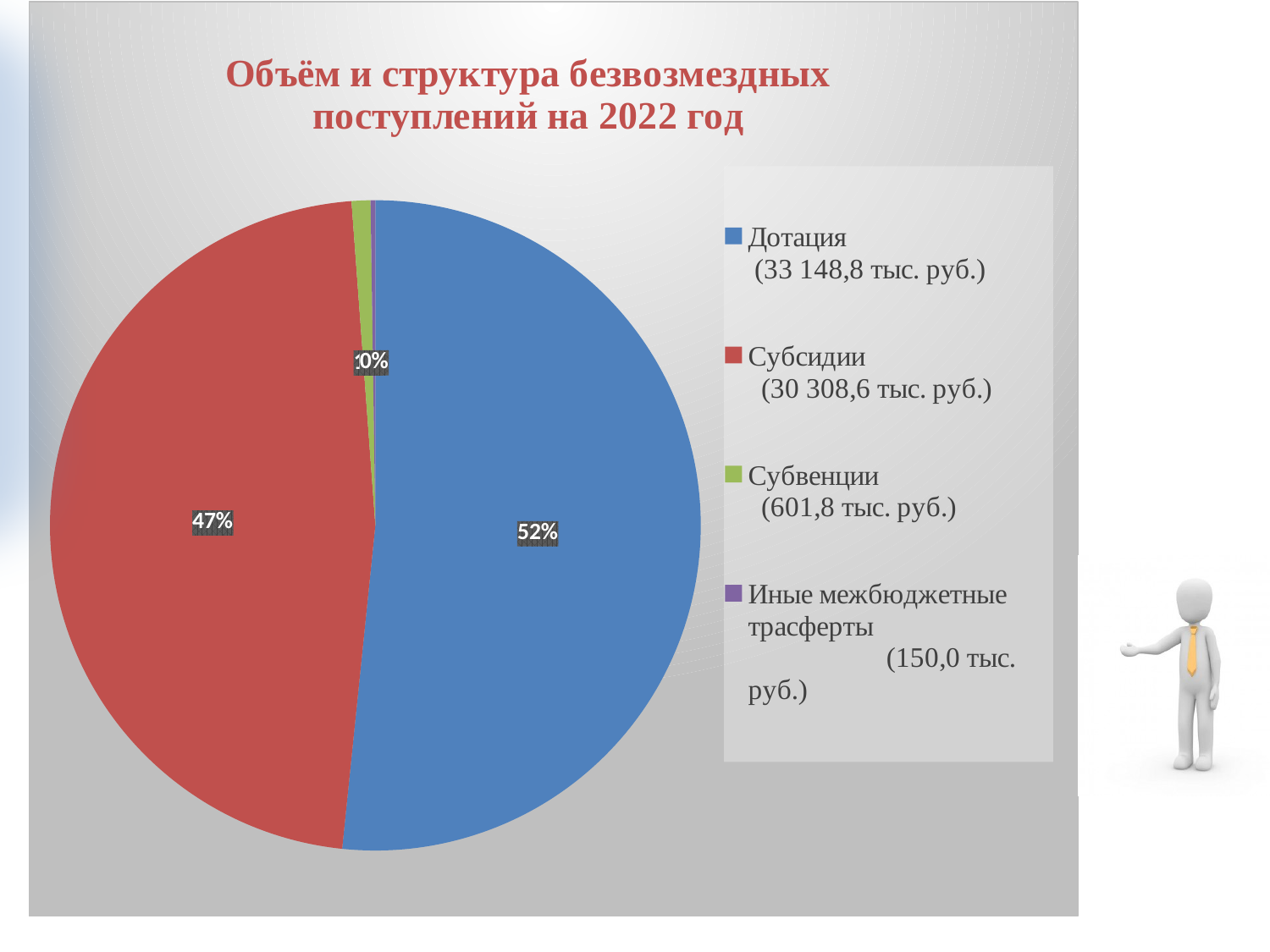
What kind of chart is shown on the slide? pie chart What amount is shown in the legend for Иные межбюджетные трасферты? 150,0 тыс. руб. What share of the pie does Дотация account for? 52% By how many percentage points does the share for Дотация exceed the share for Субсидии? 5 Which category has the largest slice of the pie? Дотация What amount is shown in the legend for Дотация? 33 148,8 тыс. руб. How many categories does the pie chart show? 4 Which category has the smallest slice of the pie? Иные межбюджетные трасферты Which is larger, the share for Дотация or the share for Субсидии? Дотация What is the title of the chart? Объём и структура безвозмездных поступлений на 2022 год What share of the pie does Субсидии account for? 47% What amount is shown in the legend for Субвенции? 601,8 тыс. руб.